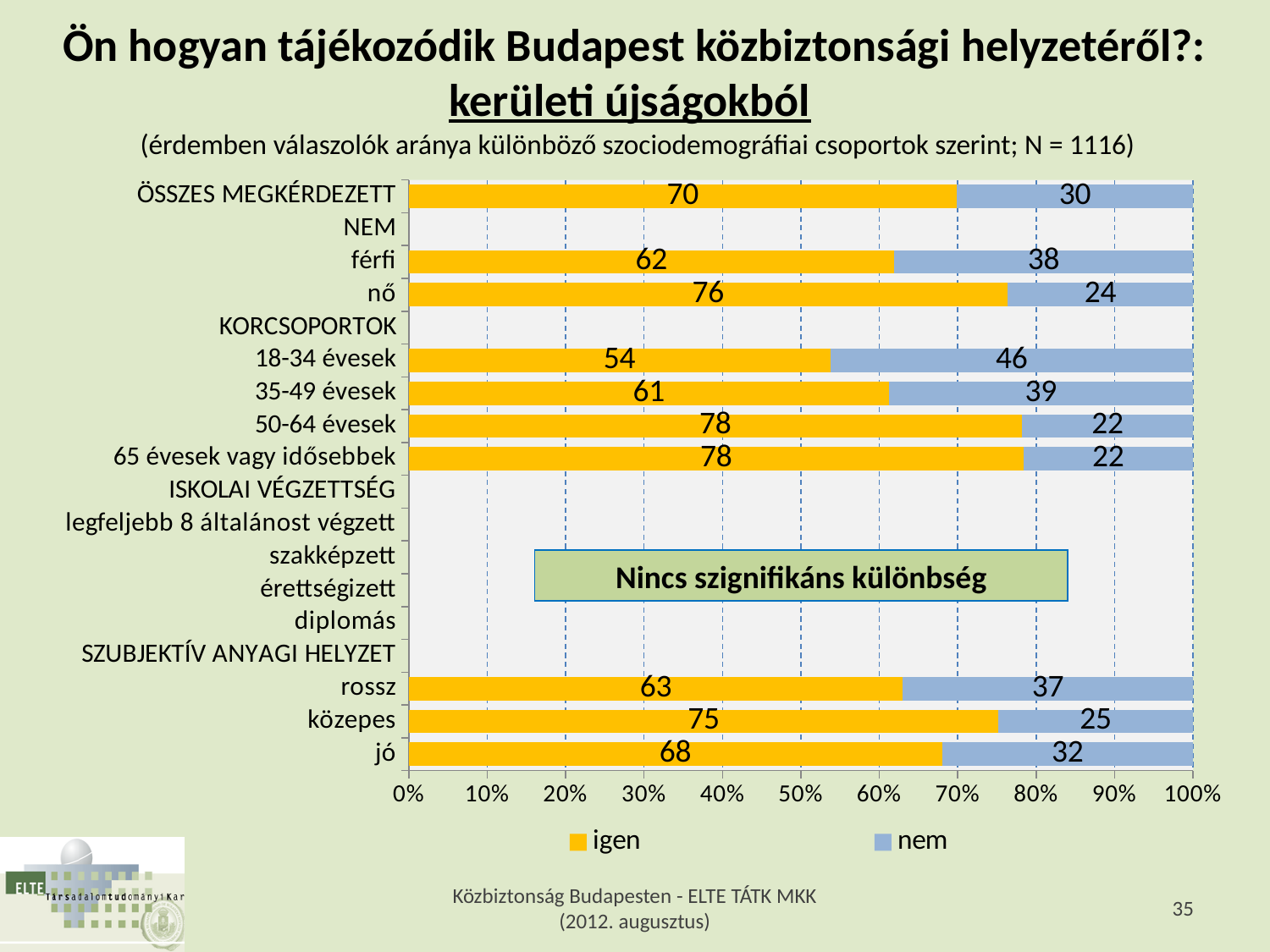
Which category has the lowest "igen" value? 18-34 évesek Which category has the highest "nem" value? 18-34 évesek What is the total of the stacked bar for "ÖSSZES MEGKÉRDEZETT"? 100 What is the difference between the "igen" values for "nő" and "férfi"? 14 What is the value of the "igen" series for "közepes"? 75 What kind of chart is shown on the slide? Stacked bar chart What are the two legend entries of the chart? igen, nem What is the value of the "nem" series for "18-34 évesek"? 46 What is the value of the "igen" series for "nő"? 76 How many series does the legend list? 2 Which has the larger "igen" value, "rossz" or "jó"? jó What text is shown in the box over the empty education rows of the chart? Nincs szignifikáns különbség